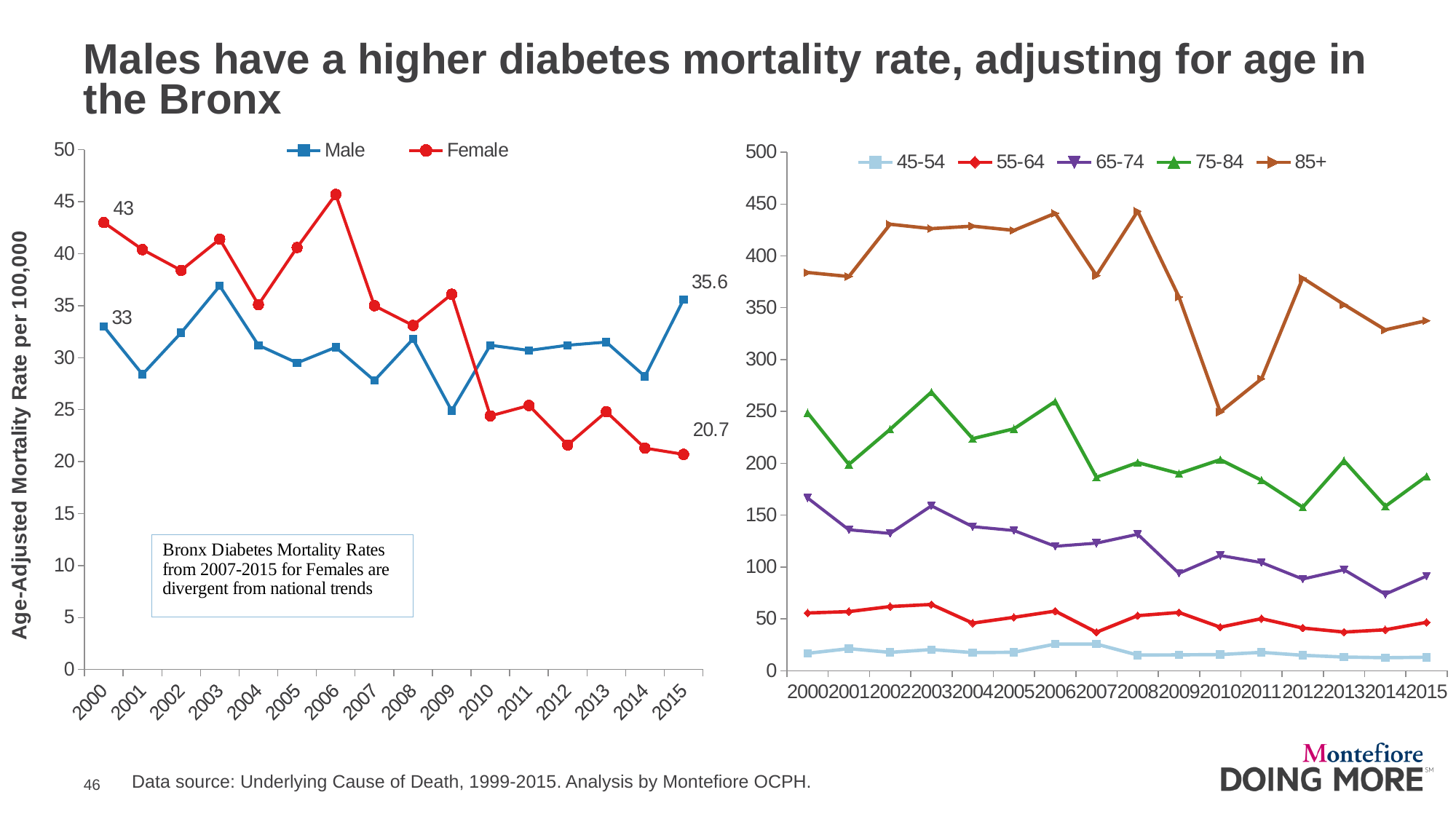
In the left chart, how many series does the legend list? 2 In the right chart, how many series does the legend list? 5 In the left chart, what is the Female value in 2015? 20.7 In the left chart, what is the Female value in 2000? 43 In the right chart, is the value for 85+ in 2010 greater or less than 300? less In the right chart, which age group has the highest values across the years? 85+ What kind of chart is the right chart? line chart In the left chart, what is the Male value in 2000? 33 In the left chart, what is the Male value in 2015? 35.6 In the left chart, what is the difference between the Male and Female values in 2015? 14.9 In the left chart, does the Female series rise or fall overall from 2000 to 2015? fall In the left chart, which series has the larger value in 2000, Male or Female? Female